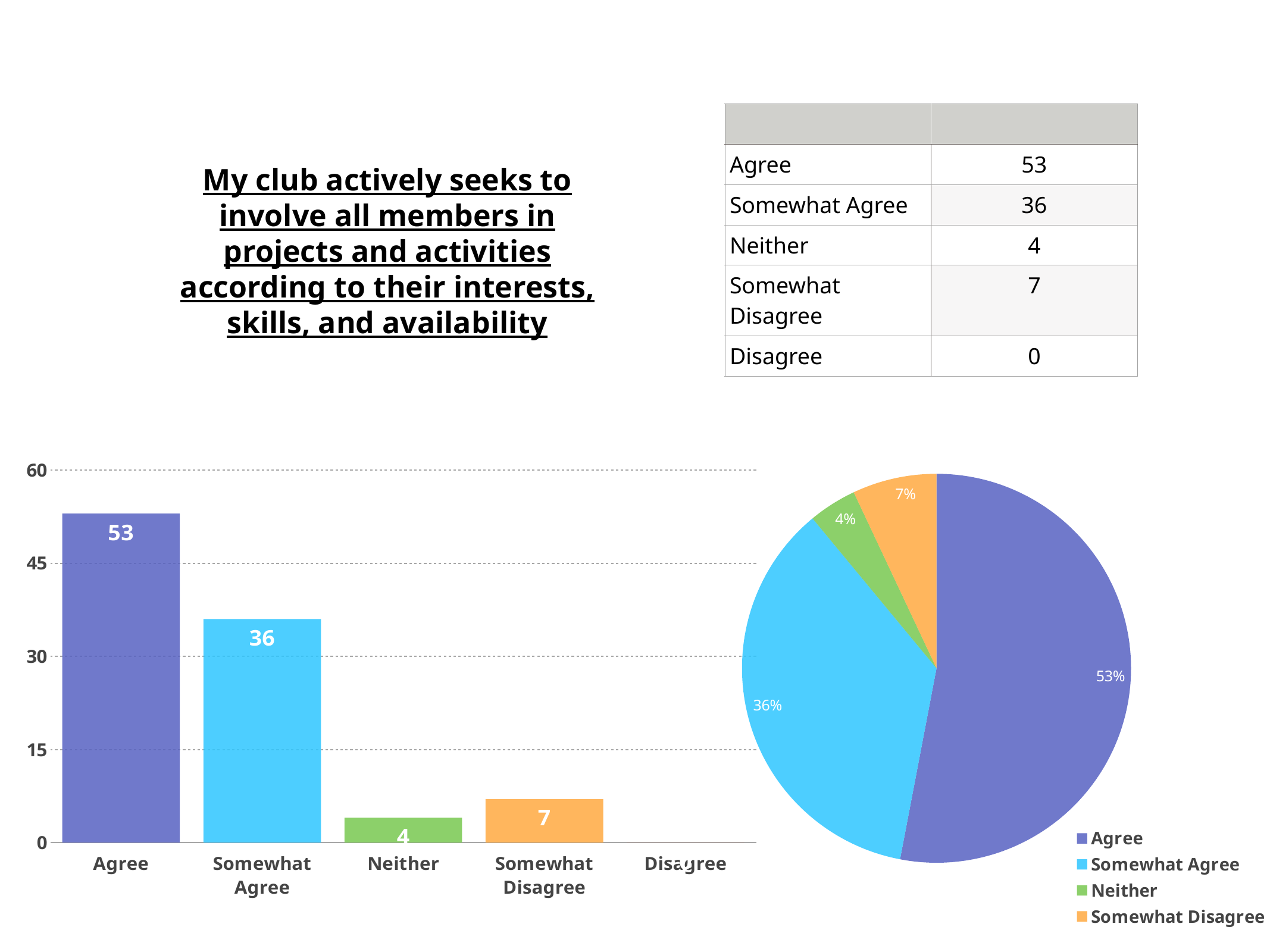
In the bar chart on the left, which category has the highest value? Agree In the bar chart on the left, what is the difference between the values for Agree and Somewhat Agree? 17 In the bar chart on the left, what is the value for Agree? 53 In the pie chart on the right, what share does Somewhat Agree have? 36% What kind of chart is shown on the bottom left of the slide? bar chart How many categories are shown on the x axis of the bar chart on the left? 5 In the bar chart on the left, which labelled bar has the lowest value? Neither In the bar chart on the left, which is larger, Somewhat Disagree or Neither? Somewhat Disagree In the bar chart on the left, is the value for Somewhat Agree greater or less than 30? greater In the bar chart on the left, what is the value for Somewhat Agree? 36 In the bar chart on the left, what is the value for Neither? 4 How many entries does the legend of the pie chart on the right list? 4